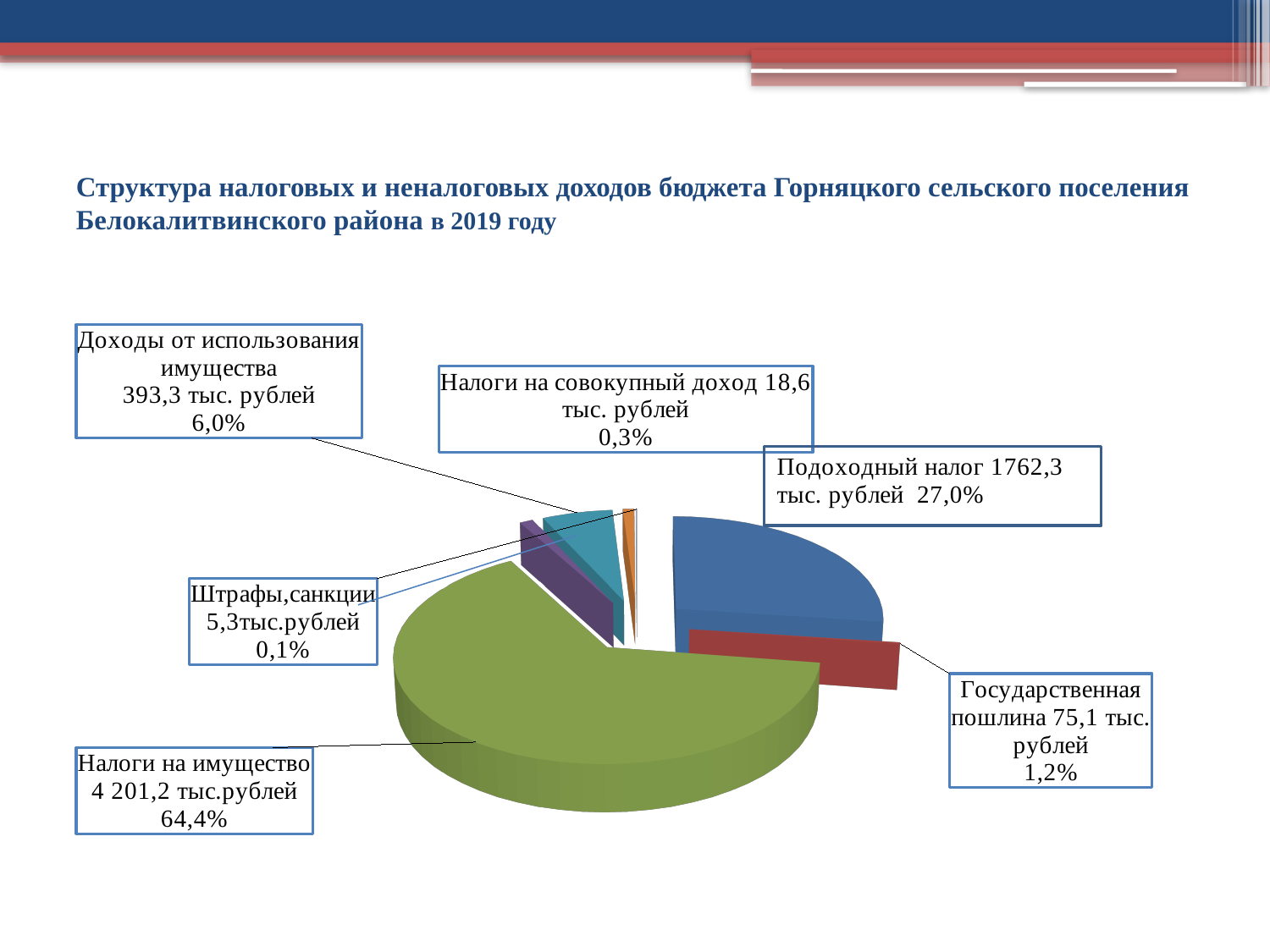
What share of the pie does Налоги на совокупный доход represent? 0,3% What is the difference in percentage share between Налоги на имущество and Подоходный налог? 37,4% What is the value for Государственная пошлина? 75,1 тыс. рублей Which is larger, Подоходный налог or Доходы от использования имущества? Подоходный налог Which category has the largest slice of the pie? Налоги на имущество What is the value for Подоходный налог? 1762,3 тыс. рублей Which category has the smallest slice of the pie? Штрафы,санкции What is the value for Налоги на имущество? 4 201,2 тыс.рублей What kind of chart is shown on the slide? Pie chart How many slices does the pie chart have? 7 What share of the pie does Доходы от использования имущества represent? 6,0% What year does the chart title refer to? 2019